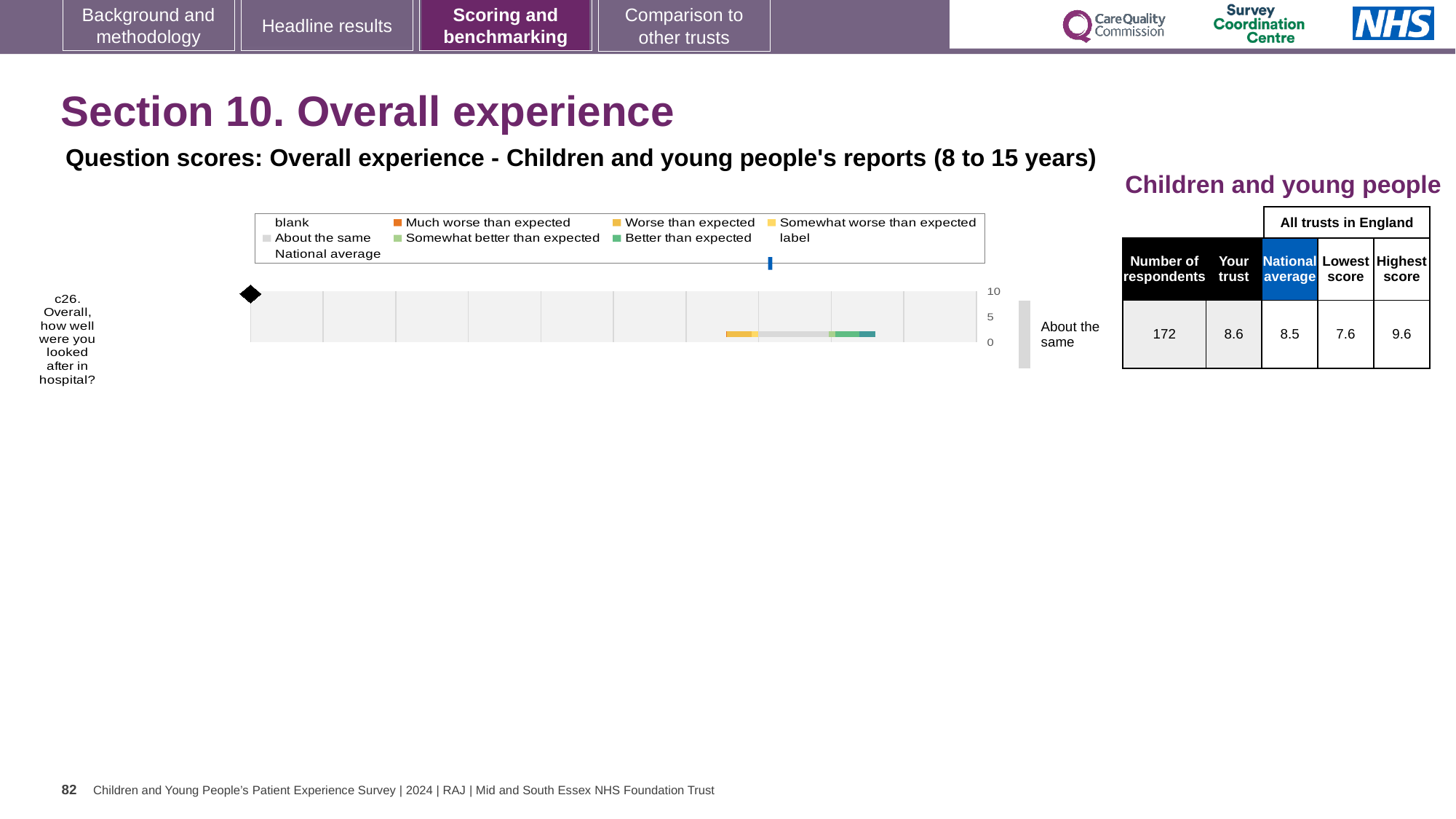
Which question is plotted on the chart? c26. Overall, how well were you looked after in hospital? In the table beside the chart, what is the 'Your trust' score for question c26? 8.6 In the table beside the chart, what is the lowest score among all trusts in England for question c26? 7.6 How many survey questions (categories) are plotted on the chart? 1 What benchmark category label is shown to the right of the bar for question c26? About the same In the table beside the chart, what is the highest score among all trusts in England for question c26? 9.6 What is the highest value shown on the chart's axis? 10 Is the 'Your trust' score for question c26 higher or lower than the national average? higher In the table beside the chart, what is the number of respondents for question c26? 172 In the table beside the chart, what is the national average score for question c26? 8.5 What is the difference between the highest score and the lowest score among all trusts in England for question c26? 2.0 What kind of chart is shown on the slide? bar chart